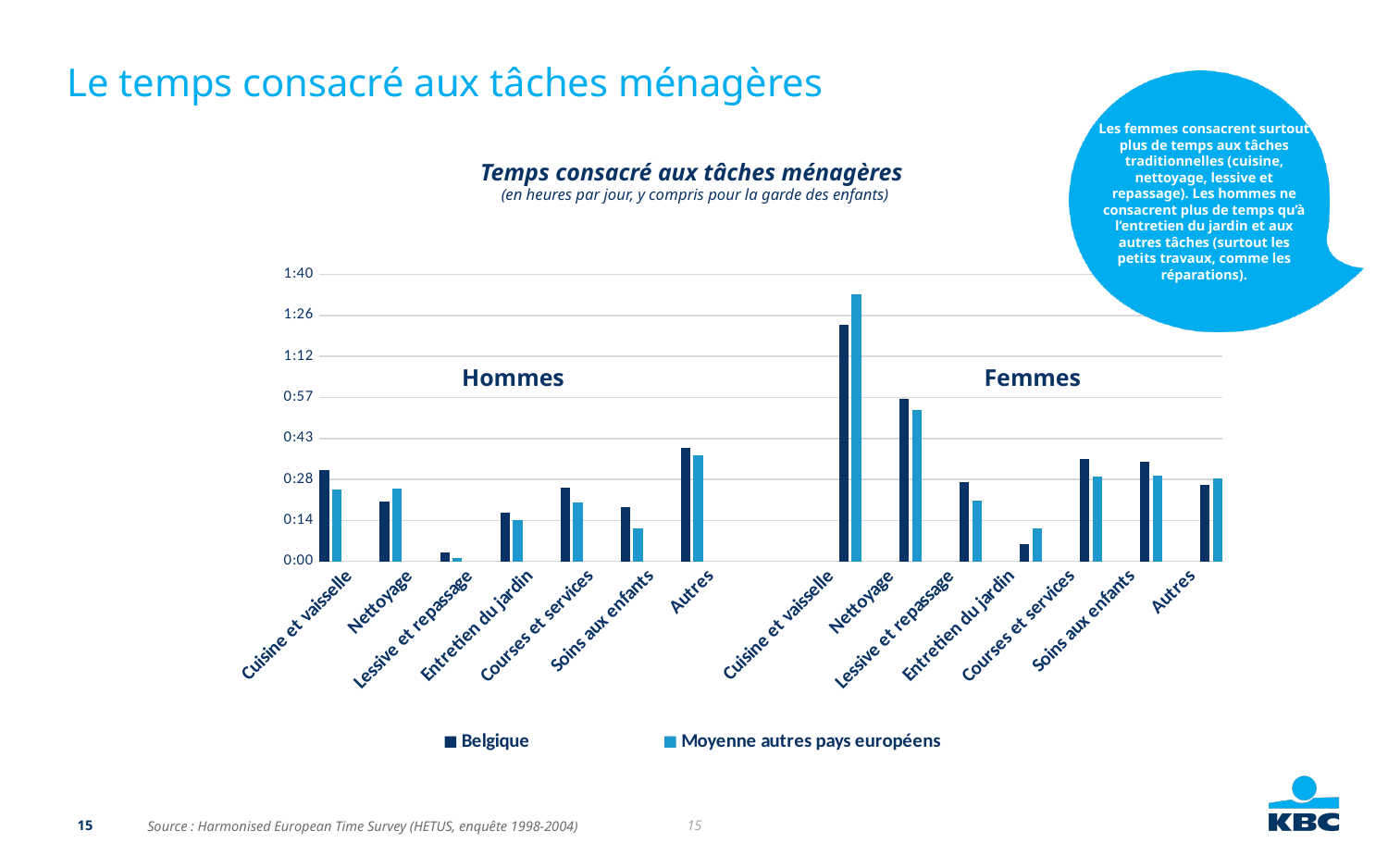
Is the Belgique value for Autres in the Hommes group greater or less than 0:28? greater How many task categories are shown in the Hommes group? 7 For Soins aux enfants in the Hommes group, which is larger: Belgique or Moyenne autres pays européens? Belgique How many series does the legend list? 2 Within the Hommes group, which category has the lowest Belgique bar? Lessive et repassage What kind of chart is shown on the slide? Bar chart Which category has the tallest Belgique bar on the whole chart? Cuisine et vaisselle (Femmes) Is the Moyenne autres pays européens value for Cuisine et vaisselle in the Femmes group greater or less than 1:26? greater What are the two series named in the legend? Belgique; Moyenne autres pays européens Is the Belgique value for Lessive et repassage in the Hommes group greater or less than 0:14? less For Entretien du jardin in the Femmes group, which is larger: Belgique or Moyenne autres pays européens? Moyenne autres pays européens Within the Hommes group, which category has the highest Belgique bar? Autres